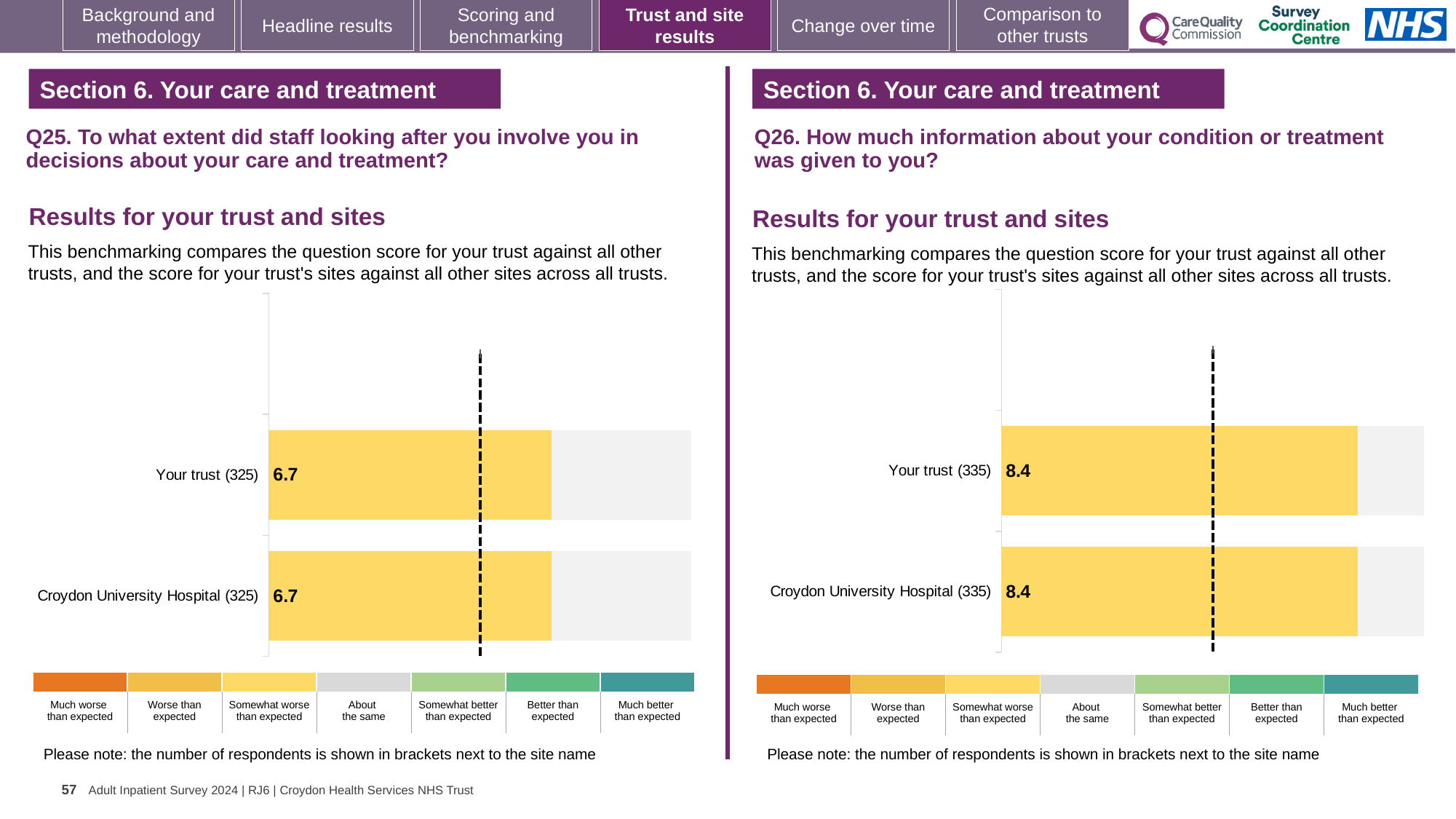
On the Q26 chart (right), what is the score for Your trust? 8.4 On the Q25 chart (left), what is the score for Croydon University Hospital? 6.7 Which chart shows the higher score for Your trust, the Q25 chart (left) or the Q26 chart (right)? Q26 chart (right) How many bars are plotted on the Q26 chart (right)? 2 What kind of chart is the Q25 chart (left)? Bar chart On the Q26 chart (right), what is the score for Croydon University Hospital? 8.4 On the Q26 chart (right), how many respondents are shown in brackets for Croydon University Hospital? 335 How many bars are plotted on the Q25 chart (left)? 2 On the Q25 chart (left), how many respondents are shown in brackets for Your trust? 325 How many categories does the colour key below the Q26 chart (right) list? 7 On the Q25 chart (left), what is the score for Your trust? 6.7 What is the difference between the Your trust score on the Q26 chart (right) and the Your trust score on the Q25 chart (left)? 1.7